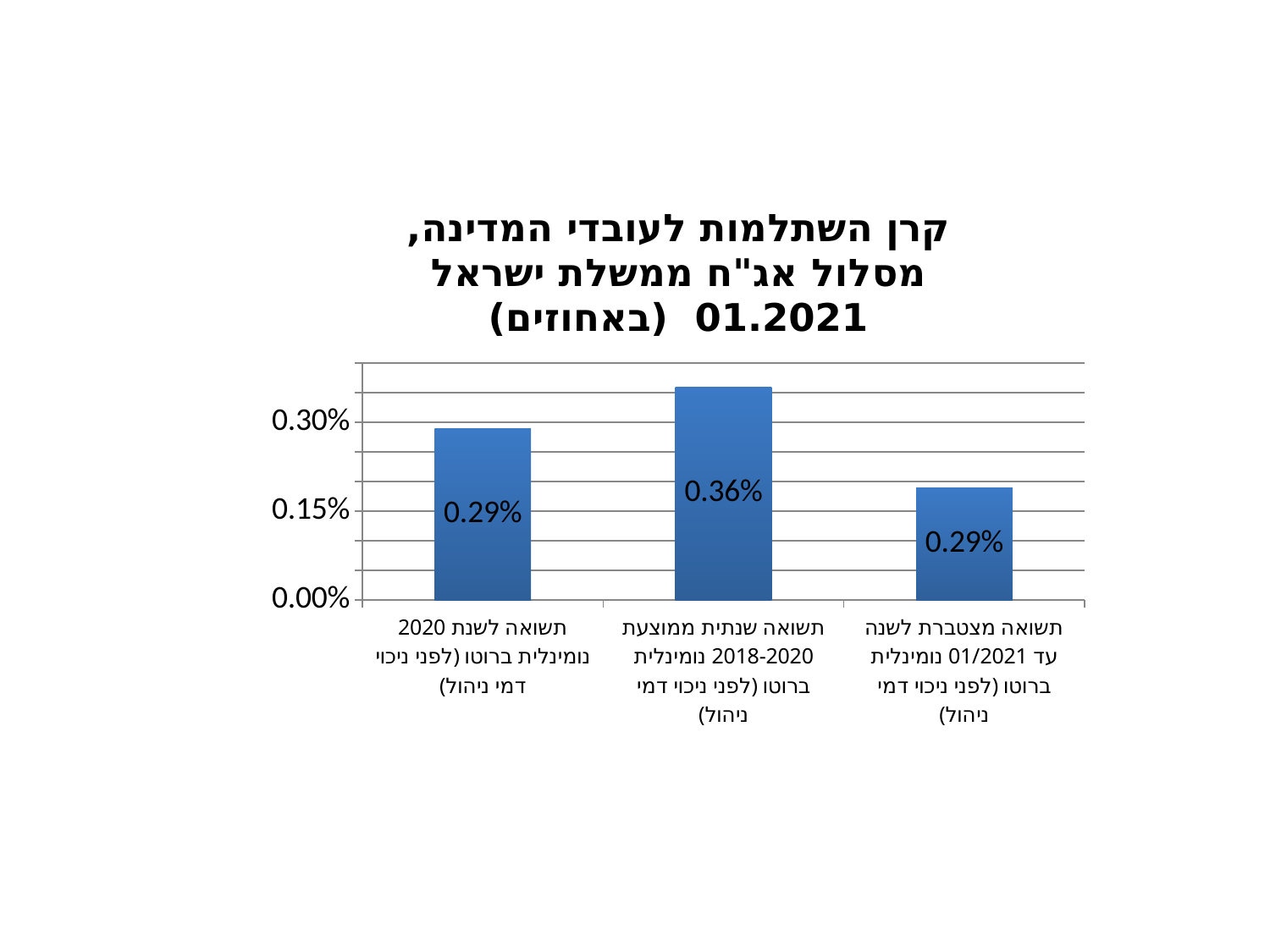
What kind of chart is shown on the slide? bar chart What is the title of the chart? קרן השתלמות לעובדי המדינה, מסלול אג"ח ממשלת ישראל 01.2021 (באחוזים) What is the highest tick value shown on the vertical axis? 0.30% What is the value for the average annual nominal gross return 2018-2020 (תשואה שנתית ממוצעת 2018-2020)? 0.36% What is the difference between the average annual return 2018-2020 and the 2020 annual return? 0.07% Which is larger: the average annual return 2018-2020 or the 2020 annual return? תשואה שנתית ממוצעת 2018-2020 Which category has the highest value? תשואה שנתית ממוצעת 2018-2020 נומינלית ברוטו (לפני ניכוי דמי ניהול) Is the value for the average annual return 2018-2020 greater or less than 0.30%? greater Is the value for the cumulative return for the year to 01/2021 greater or less than 0.15%? greater What is the value labelled on the bar for the cumulative return for the year to 01/2021 (תשואה מצטברת לשנה עד 01/2021)? 0.29% How many bars are shown in the chart? 3 What is the value for the 2020 annual nominal gross return (תשואה לשנת 2020 נומינלית ברוטו)? 0.29%